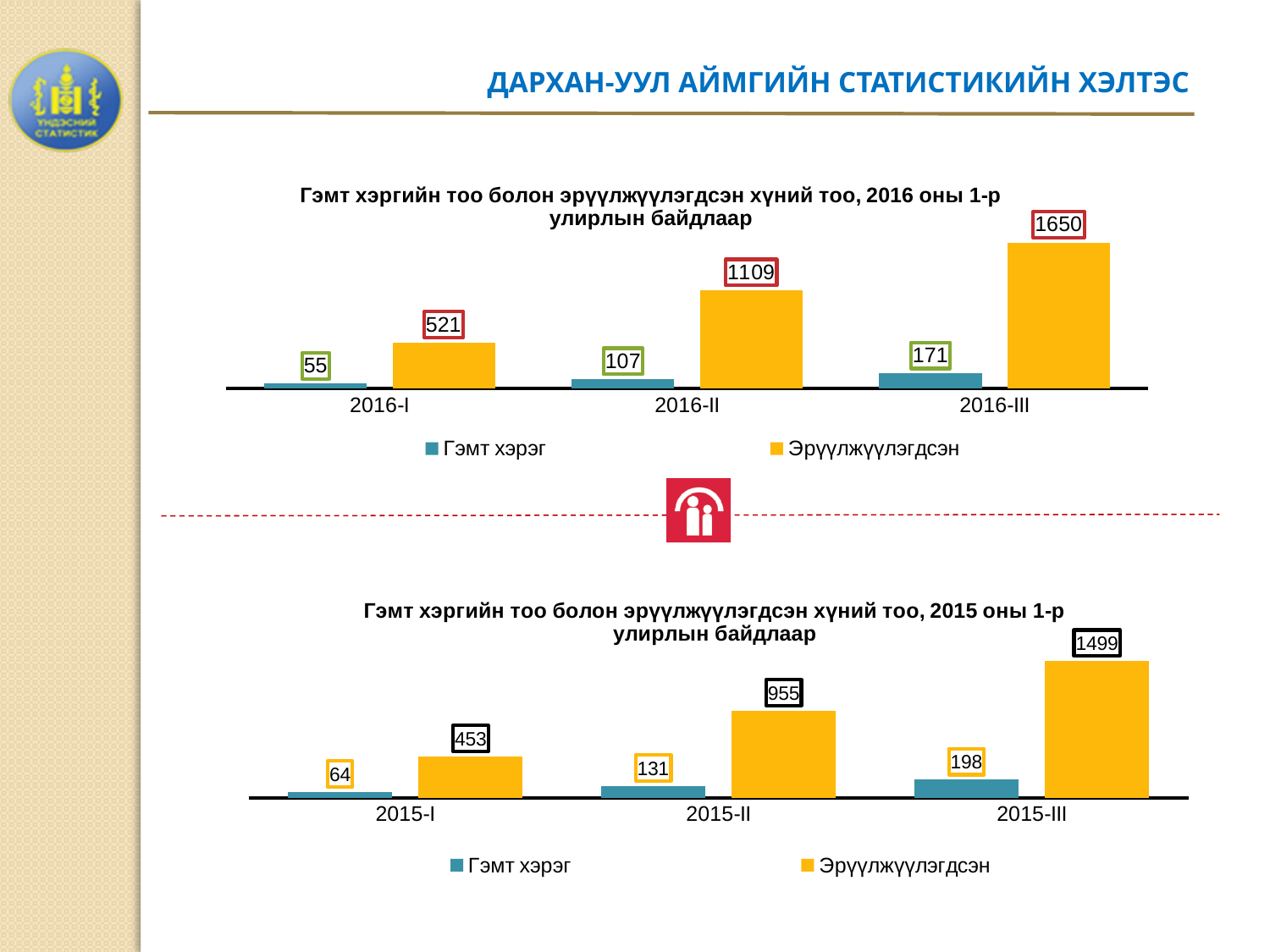
How many categories are shown on the x axis of the top chart (2016)? 3 In the top chart (2016), what is the value of Гэмт хэрэг for 2016-II? 107 In the bottom chart (2015), which category has the lowest Гэмт хэрэг value? 2015-I In the top chart (2016), what is the difference between the Эрүүлжүүлэгдсэн values for 2016-II and 2016-I? 588 How many series does the legend of the bottom chart (2015) list? 2 In the top chart (2016), what is the value of Эрүүлжүүлэгдсэн for 2016-III? 1650 In the bottom chart (2015), what is the value of Эрүүлжүүлэгдсэн for 2015-I? 453 In the top chart (2016), which category has the highest Эрүүлжүүлэгдсэн value? 2016-III Which is larger: Эрүүлжүүлэгдсэн for 2016-III in the top chart or Эрүүлжүүлэгдсэн for 2015-III in the bottom chart? 2016-III in the top chart In the bottom chart (2015), what is the value of Гэмт хэрэг for 2015-III? 198 What kind of chart is the top chart (2016)? Bar chart In the bottom chart (2015), what is the difference between the Гэмт хэрэг values for 2015-II and 2015-I? 67